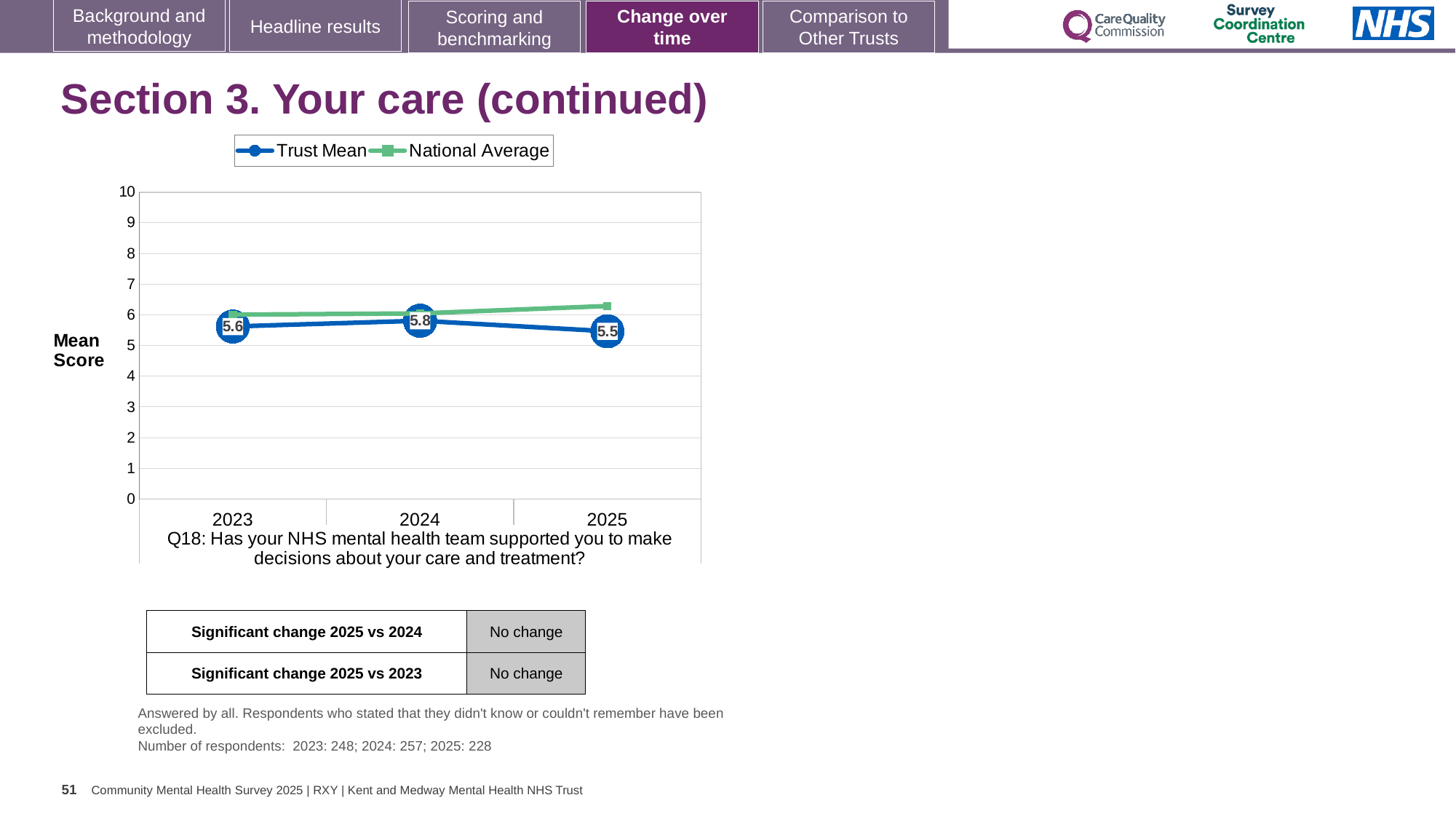
Is the National Average value for 2025 greater or less than 6? greater In 2025, which is larger: the Trust Mean or the National Average? National Average How many years are plotted on the x axis? 3 In which year is the Trust Mean score highest? 2024 In which year is the Trust Mean score lowest? 2025 What is the Trust Mean score for 2023? 5.6 What is the difference between the Trust Mean scores for 2024 and 2025? 0.3 What kind of chart is shown on the slide? Line chart Does the National Average rise or fall from 2023 to 2025? Rise What is the Trust Mean score for 2025? 5.5 How many series does the legend list? 2 What is the Trust Mean score for 2024? 5.8